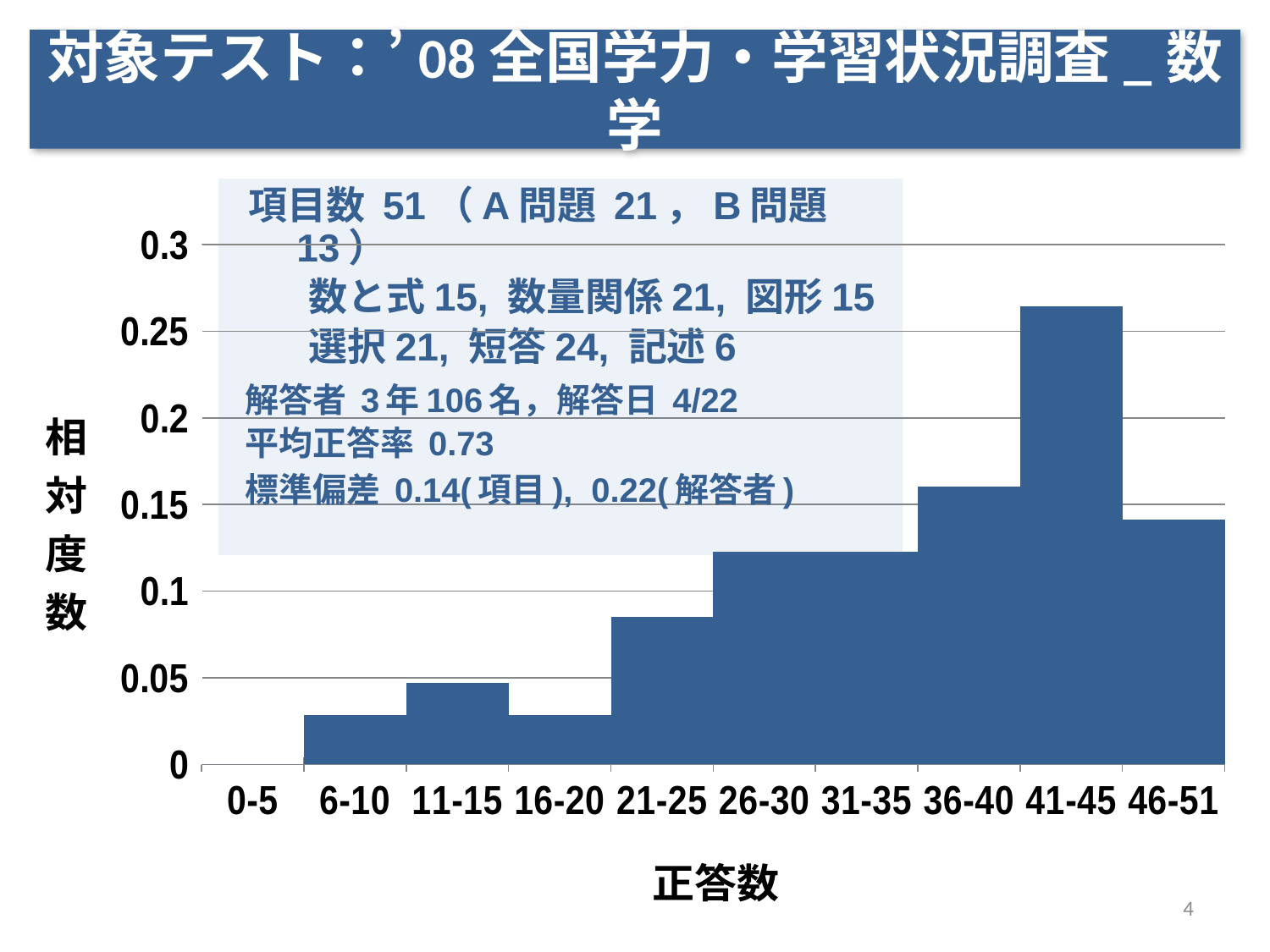
Which has the larger value, 11-15 or 16-20? 11-15 Which category has the highest relative frequency? 41-45 Is the value for 6-10 greater or less than 0.05? less Which category has the lowest relative frequency? 0-5 Is the value for 41-45 greater or less than 0.25? greater What is the label of the x axis of the chart? 正答数 Is the value for 21-25 greater or less than 0.1? less What kind of chart is shown on the slide? bar chart Which has the larger value, 41-45 or 46-51? 41-45 What is the label of the y axis of the chart? 相対度数 How many categories are shown on the x axis of the chart? 10